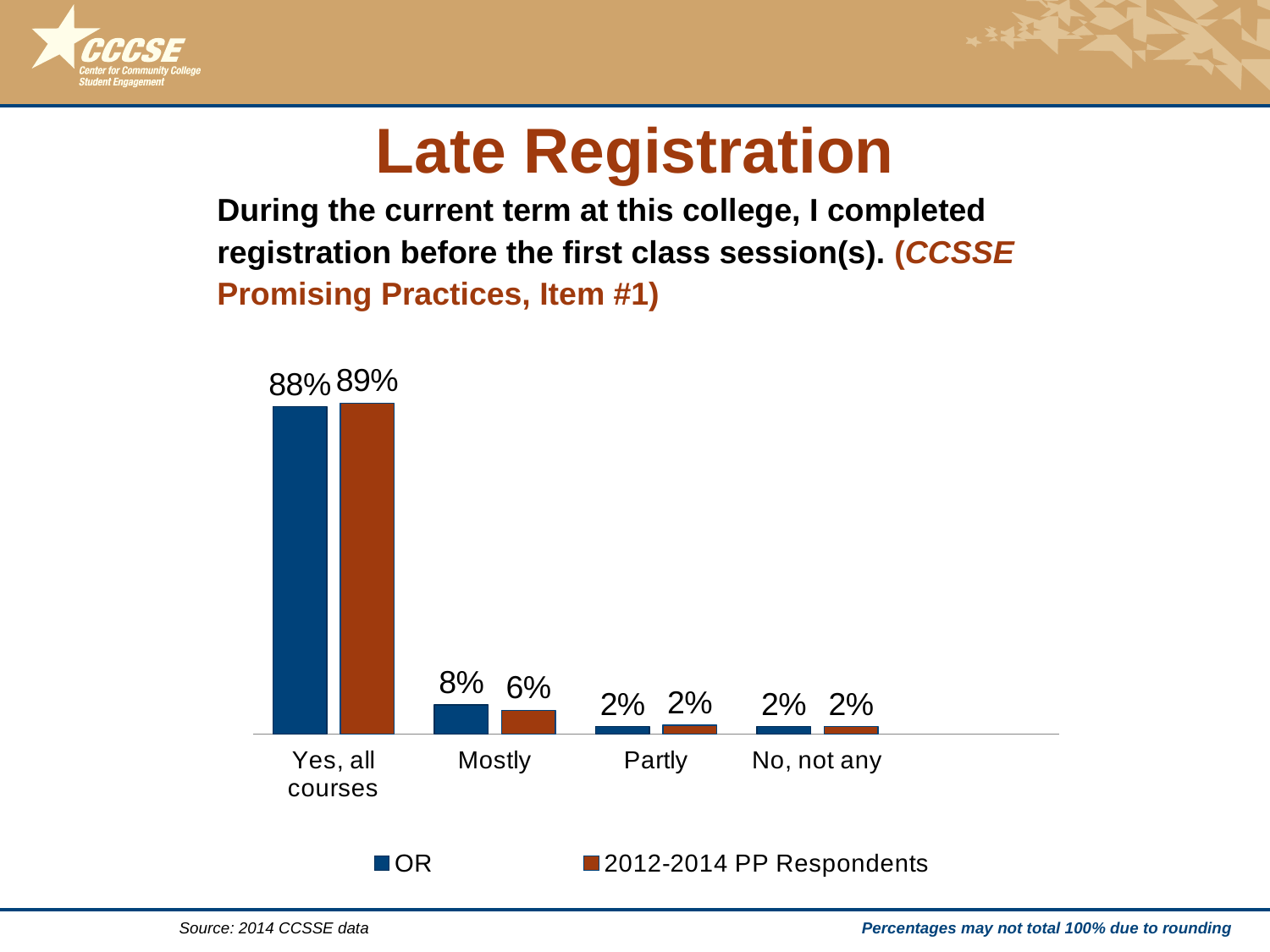
Which is larger in the "Yes, all courses" category: OR or 2012-2014 PP Respondents? 2012-2014 PP Respondents What is the value for OR in the "Partly" category? 2% How many categories are shown on the x axis? 4 Which category has the highest value for 2012-2014 PP Respondents? Yes, all courses What is the value for OR in the "Yes, all courses" category? 88% How many series does the legend list? 2 Which series is shown in blue in the legend? OR What is the difference between the OR values for "Yes, all courses" and "Mostly"? 80% What is the value for 2012-2014 PP Respondents in the "Mostly" category? 6% What kind of chart is shown on the slide? Bar chart Which is larger in the "Mostly" category: OR or 2012-2014 PP Respondents? OR What is the difference between the OR and 2012-2014 PP Respondents values in the "Mostly" category? 2%